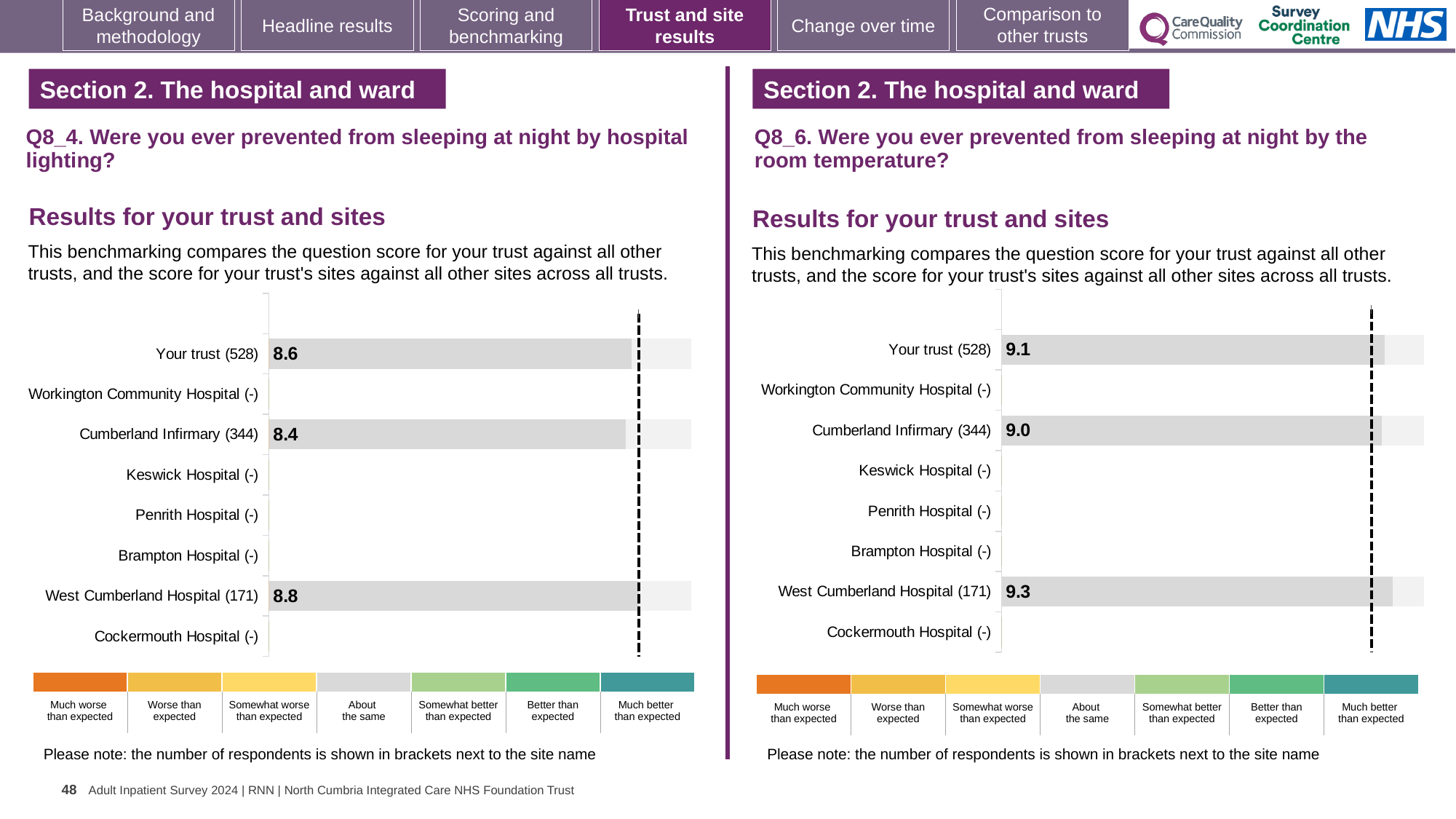
In the Q8_6 room temperature chart, which site with a plotted score has the lowest value? Cumberland Infirmary (344) How many categories are listed on the y axis of the Q8_4 hospital lighting chart? 8 In the Q8_4 hospital lighting chart, what is the difference between the scores for West Cumberland Hospital (171) and Cumberland Infirmary (344)? 0.4 In the Q8_4 hospital lighting chart, which site with a plotted score has the highest value? West Cumberland Hospital (171) In the Q8_4 hospital lighting chart, what is the score for Your trust (528)? 8.6 In the Q8_6 room temperature chart, what is the score for Cumberland Infirmary (344)? 9.0 In the Q8_6 room temperature chart, what is the score for Your trust (528)? 9.1 In the Q8_6 room temperature chart, what is the score for West Cumberland Hospital (171)? 9.3 In the Q8_4 hospital lighting chart, what is the score for West Cumberland Hospital (171)? 8.8 In the Q8_4 hospital lighting chart, what is the score for Cumberland Infirmary (344)? 8.4 In the Q8_6 room temperature chart, which is larger: the score for Your trust (528) or for West Cumberland Hospital (171)? West Cumberland Hospital (171) What kind of chart is used for the Q8_6 room temperature results? Bar chart